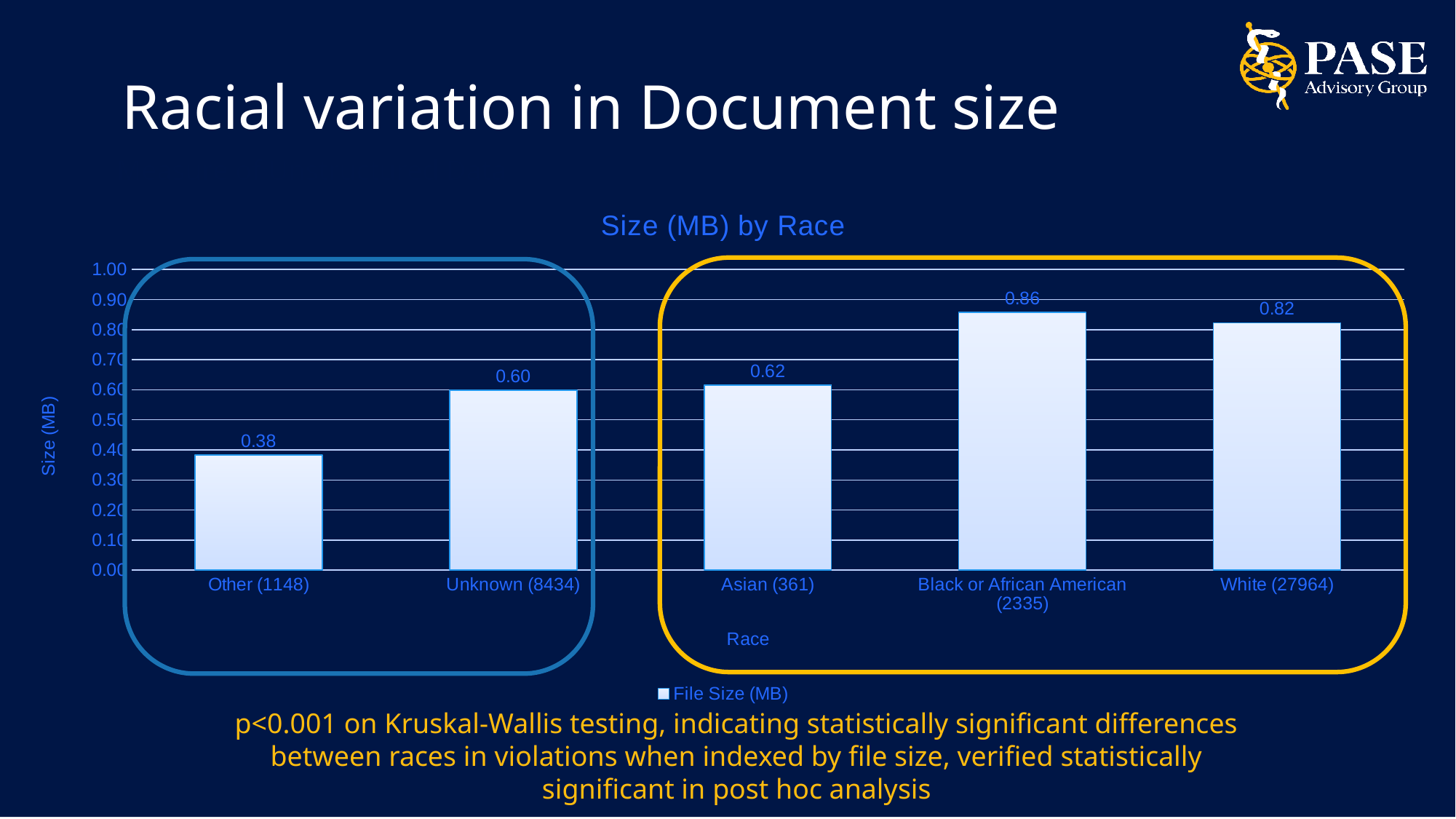
Is the value for Asian (361) greater or less than 0.50? greater Which race category has the highest file size? Black or African American (2335) What kind of chart is shown on the slide? bar chart What is the file size value for Other (1148)? 0.38 How many race categories are shown in the chart? 5 What is the difference between the file size for Unknown (8434) and Other (1148)? 0.22 Which has a larger file size, Asian (361) or White (27964)? White (27964) Which race category has the lowest file size? Other (1148) What is the file size value for Black or African American (2335)? 0.86 What is the title of the chart? Size (MB) by Race What is the file size value for White (27964)? 0.82 How many series does the legend list? 1